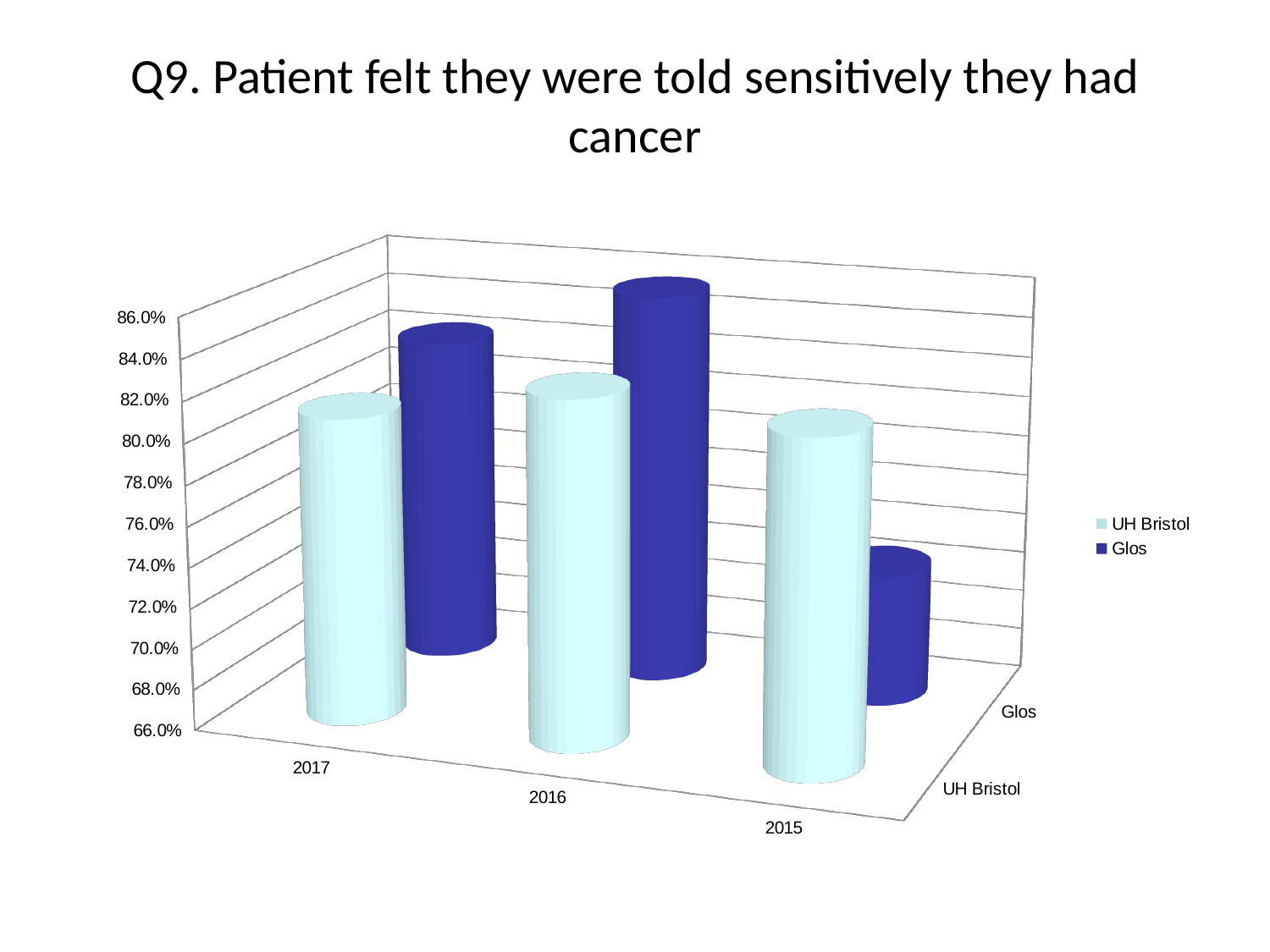
For the Glos series, which year has the lowest value? 2015 What is the title of the chart? Q9. Patient felt they were told sensitively they had cancer How many series does the legend list? 2 Which is larger for Glos: the value in 2016 or the value in 2015? 2016 What kind of chart is shown on the slide? bar chart How many year categories are shown on the x axis? 3 Which series is shown in dark blue? Glos Is the value for UH Bristol in 2015 greater or less than 76.0%? greater Which bar is the lowest on the whole chart? Glos 2015 Is the value for Glos in 2015 greater or less than 78.0%? less For the Glos series, which year has the highest value? 2016 Is the value for Glos in 2016 greater or less than 80.0%? greater